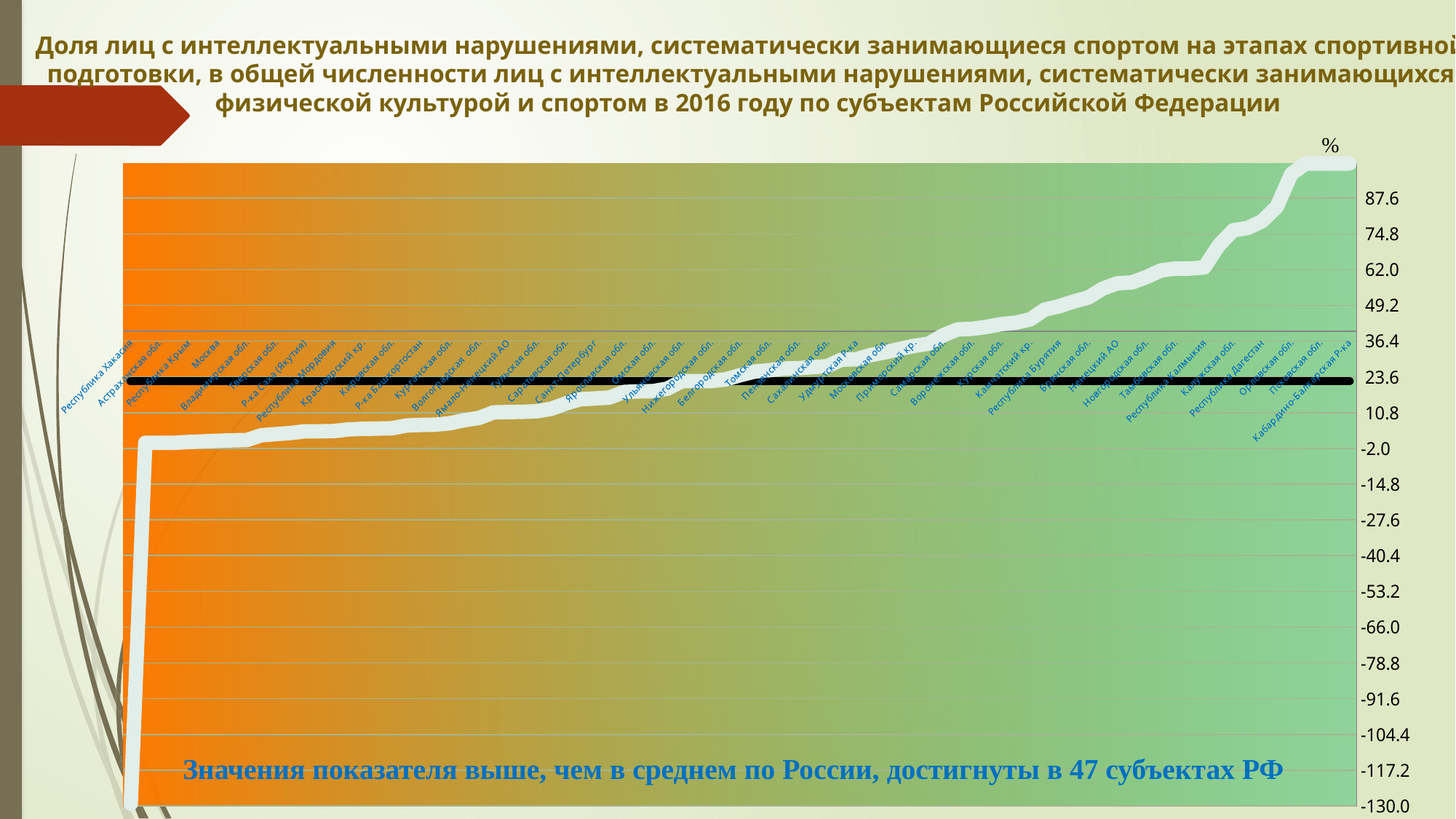
Is the value for Республика Хакасия greater or less than -104.4? less Is the value for Кабардино-Балкарская Р-ка greater or less than 87.6? greater What unit is shown at the top of the vertical axis? % Is the value for Москва greater or less than 10.8? less According to the note on the chart, in how many subjects of the Russian Federation are the values above the Russian average? 47 What kind of chart is shown on the slide? line chart Which has the larger value, Санкт-Петербург or Республика Дагестан? Республика Дагестан Which region has the lowest value on the chart? Республика Хакасия Do the values rise or fall along the x axis from Республика Хакасия to Кабардино-Балкарская Р-ка? rise